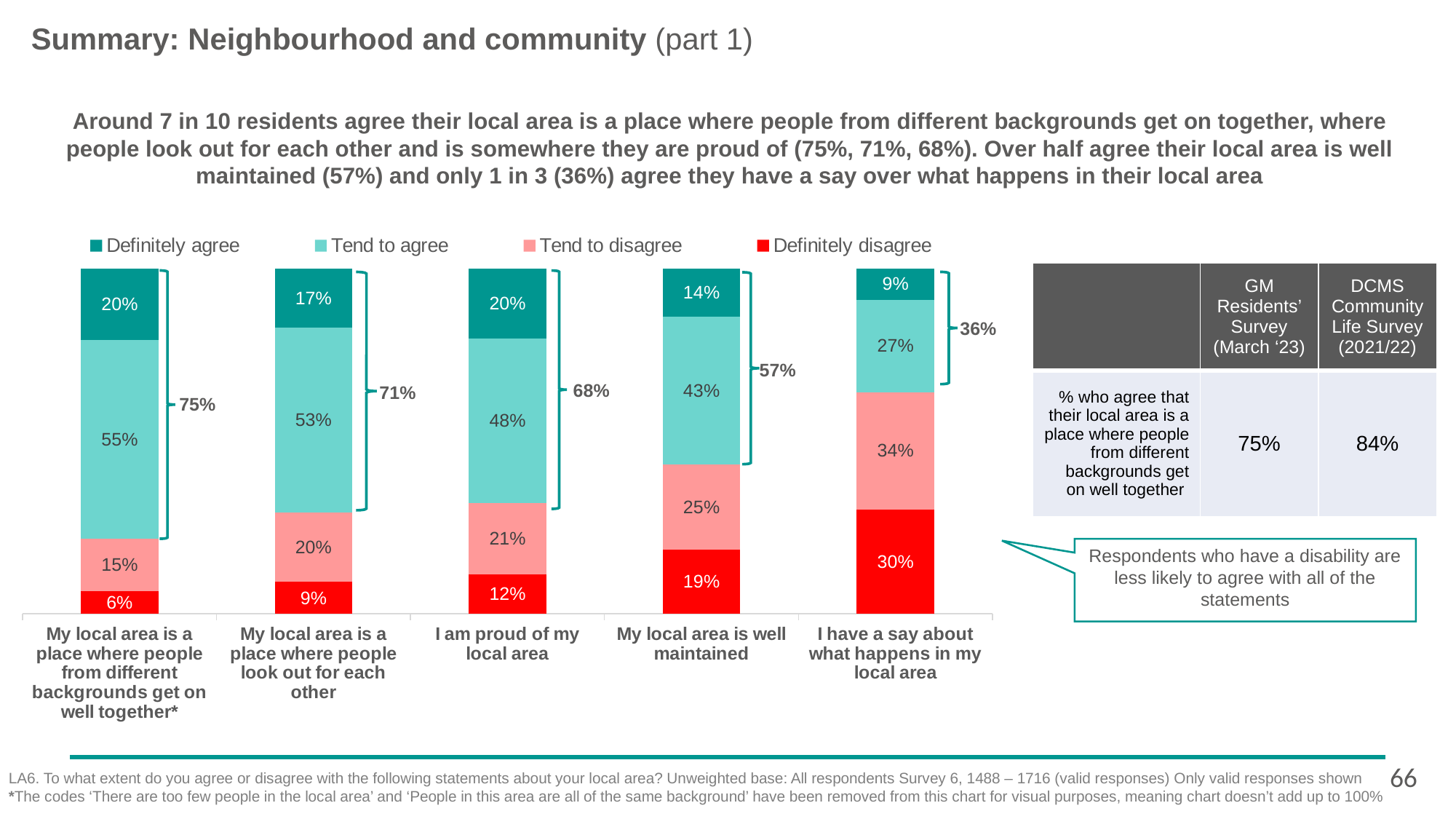
What is the 'Tend to disagree' value for the statement 'I have a say about what happens in my local area'? 34% What is the combined percentage who agree (definitely agree plus tend to agree) that their local area is well maintained? 57% What type of chart is used to show the responses? Stacked bar chart What is the difference in the 'Tend to agree' percentage between 'My local area is a place where people from different backgrounds get on well together' and 'My local area is a place where people look out for each other'? 2 percentage points Which has a larger 'Tend to disagree' percentage: 'My local area is well maintained' or 'I am proud of my local area'? My local area is well maintained What percentage of respondents 'Tend to agree' with the statement 'I am proud of my local area'? 48% Do the 'Definitely disagree' values rise or fall moving from left to right across the statements? Rise How many statements (bars) are shown in the chart? 5 Which statement has the lowest 'Definitely agree' percentage? I have a say about what happens in my local area What percentage 'Definitely disagree' with the statement 'My local area is well maintained'? 19% How many response categories does the chart legend list? 4 Which statement has the highest 'Definitely disagree' percentage? I have a say about what happens in my local area